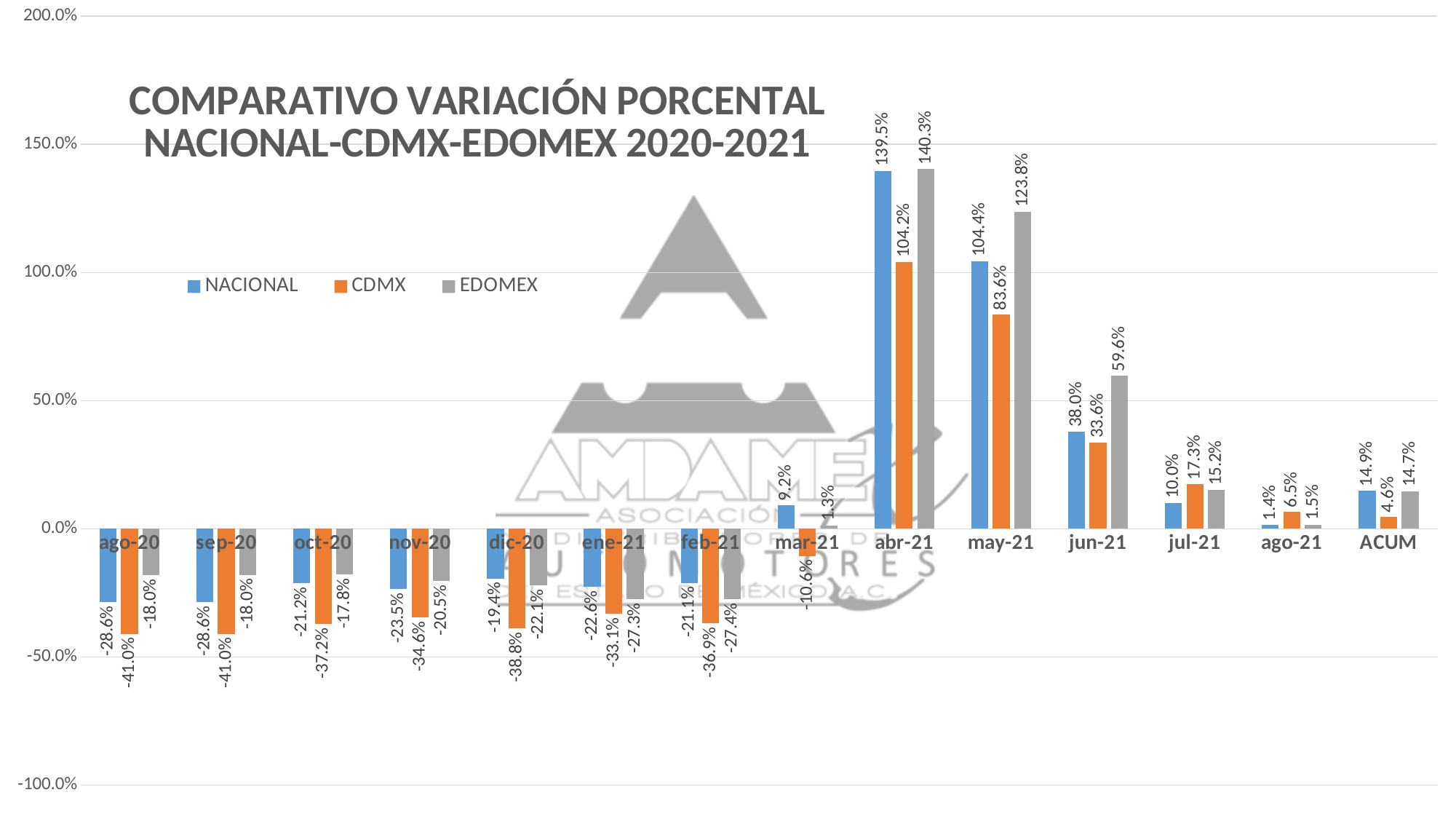
What is the difference between the EDOMEX and CDMX values for may-21? 40.2% What kind of chart is shown on the slide? Bar chart What is the EDOMEX value for jun-21? 59.6% Which category has the lowest CDMX value? ago-20 and sep-20 (both -41.0%) Which is larger for jul-21, the NACIONAL value or the CDMX value? CDMX How many categories are shown on the x axis? 14 How many series does the legend list? 3 What is the CDMX value for may-21? 83.6% What is the NACIONAL value for abr-21? 139.5% What is the title of the chart? COMPARATIVO VARIACIÓN PORCENTAL NACIONAL-CDMX-EDOMEX 2020-2021 Which category has the highest EDOMEX value? abr-21 What is the CDMX value for ago-20? -41.0%